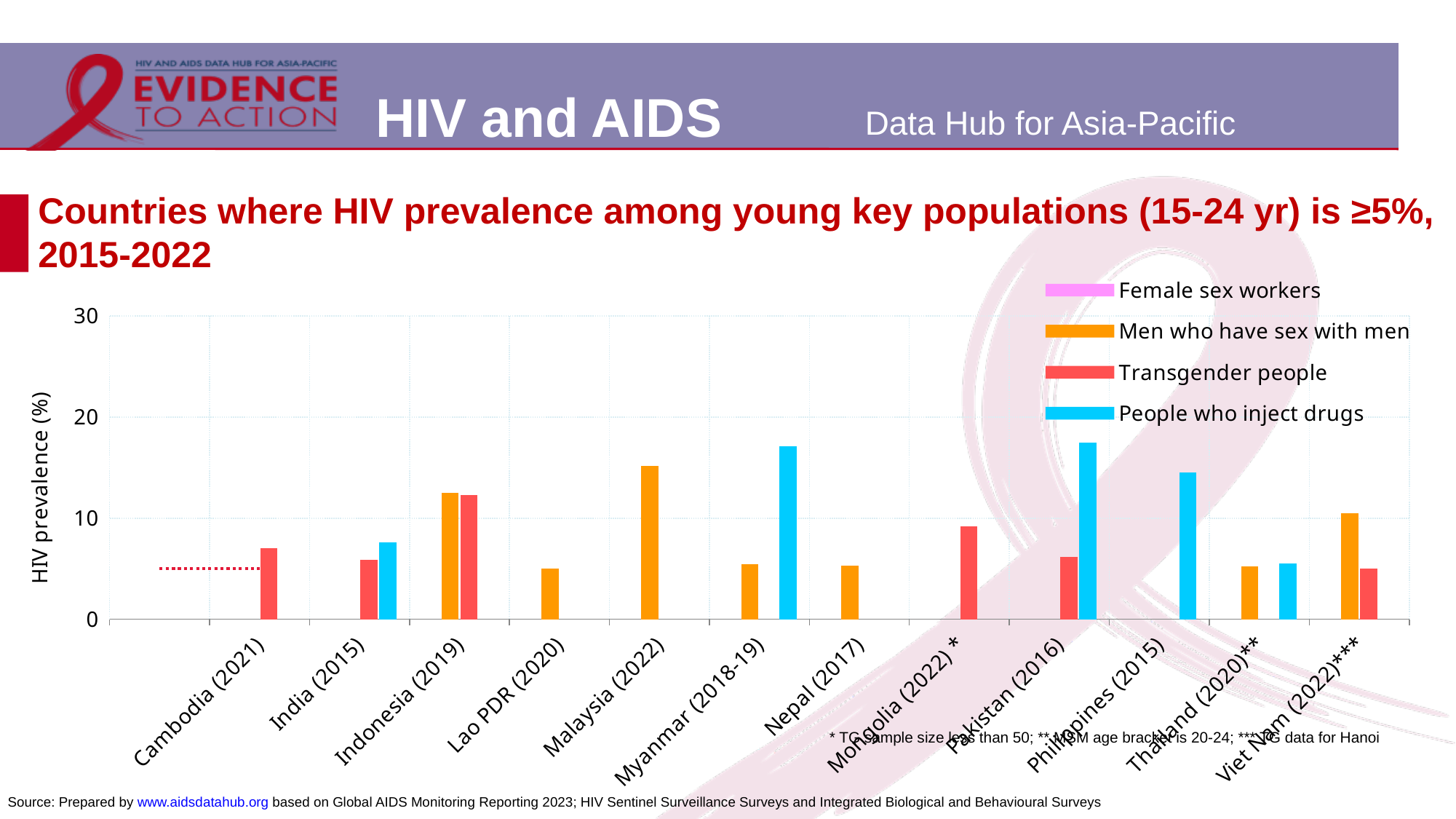
Is the value for Men who have sex with men in Lao PDR (2020) greater or less than 10? less Is the value for People who inject drugs in Myanmar (2018-19) greater or less than 10? greater How many countries are shown along the x axis? 12 Which country has the highest value for Transgender people? Indonesia (2019) Is the value for Transgender people in Cambodia (2021) greater or less than 10? less What kind of chart is shown on the slide? bar chart What is the label on the y axis? HIV prevalence (%) How many series does the legend list? 4 Which country has the highest value for Men who have sex with men? Malaysia (2022)